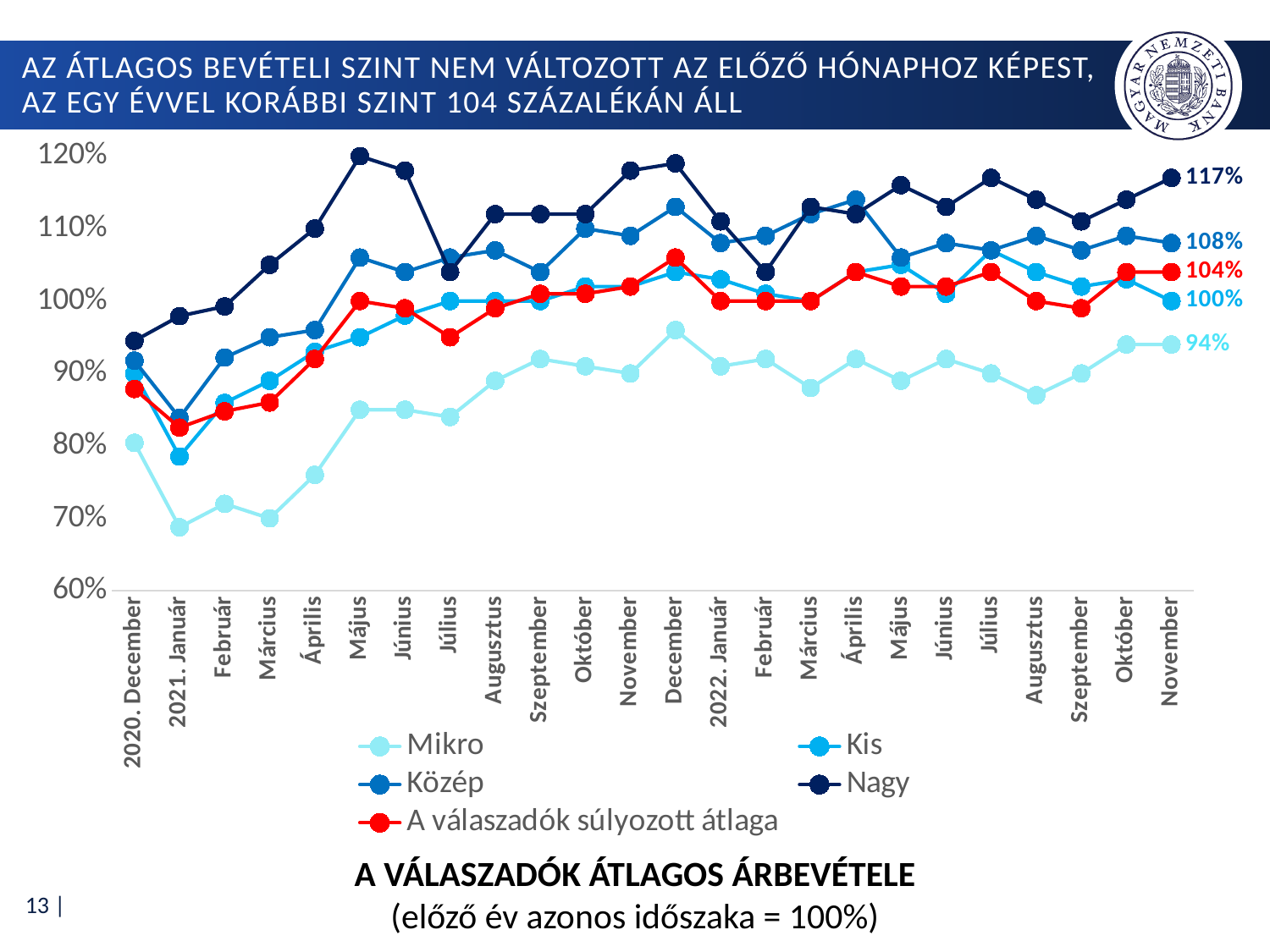
What is the value for the Közép series in November (2022)? 108% Which series has the lowest value in November (2022)? Mikro Which series has the highest value in November (2022)? Nagy What is the value for the Mikro series in November (2022)? 94% What is the value for the Kis series in November (2022)? 100% How many months are plotted along the x axis? 24 What is the value for 'A válaszadók súlyozott átlaga' in November (2022)? 104% How many series does the legend list? 5 What kind of chart is shown on the slide? line chart What is the value for the Nagy series in November (2022)? 117% Is the value for the Nagy series in Május 2021 greater or less than 110%? greater What is the difference between the Nagy and Mikro values in November (2022)? 23 percentage points